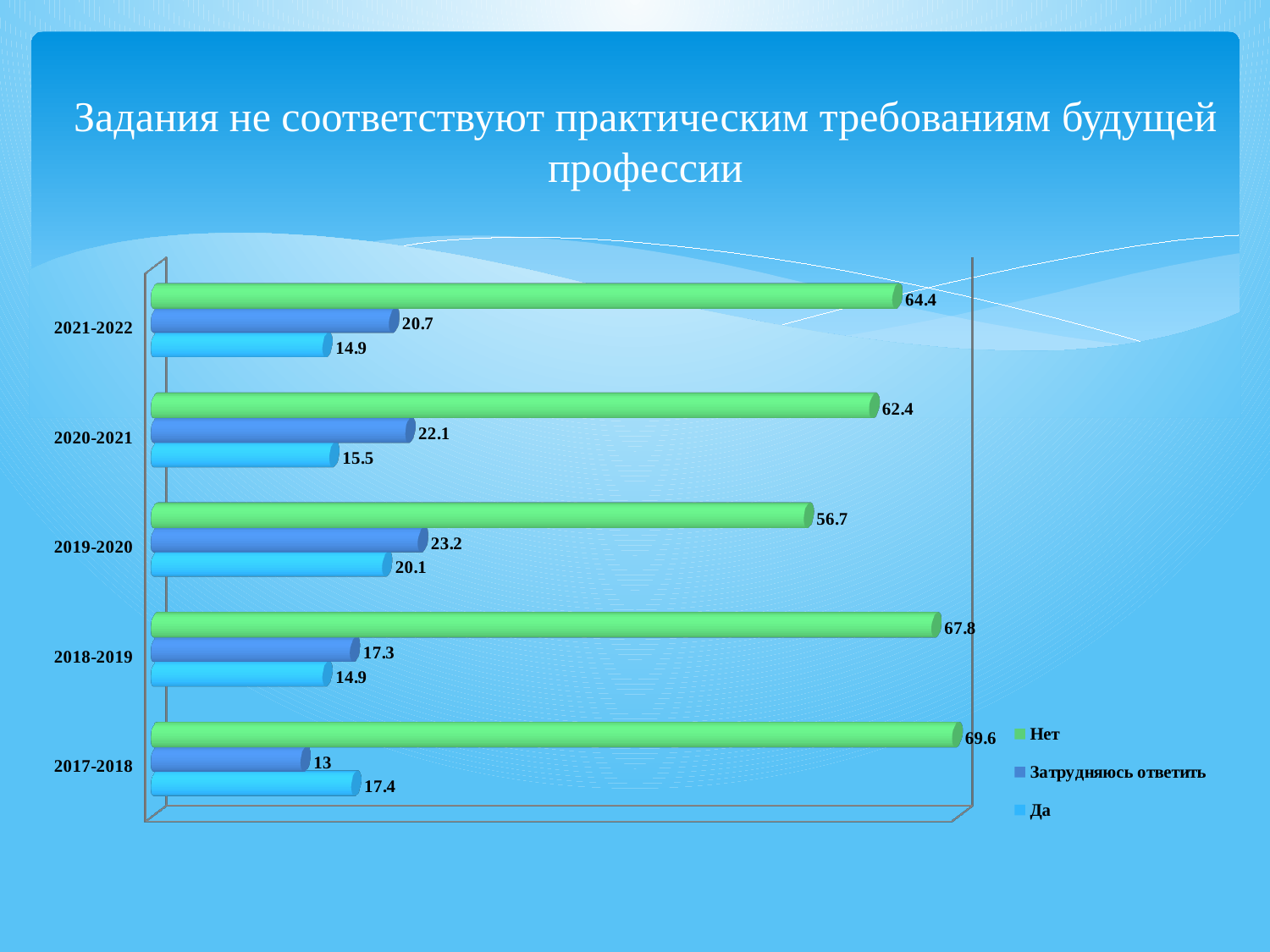
Which series is shown in green in the legend? Нет In which year is the value for "Нет" the highest? 2017-2018 What is the value for "Да" in 2019-2020? 20.1 What is the value for "Нет" in 2021-2022? 64.4 Which is larger in 2017-2018: "Да" or "Затрудняюсь ответить"? Да What is the value for "Затрудняюсь ответить" in 2020-2021? 22.1 What is the value for "Затрудняюсь ответить" in 2017-2018? 13 What is the difference between the "Нет" values for 2018-2019 and 2019-2020? 11.1 In which year is the value for "Нет" the lowest? 2019-2020 How many series does the legend list? 3 How many year categories are shown on the chart? 5 What kind of chart is shown on the slide? Bar chart